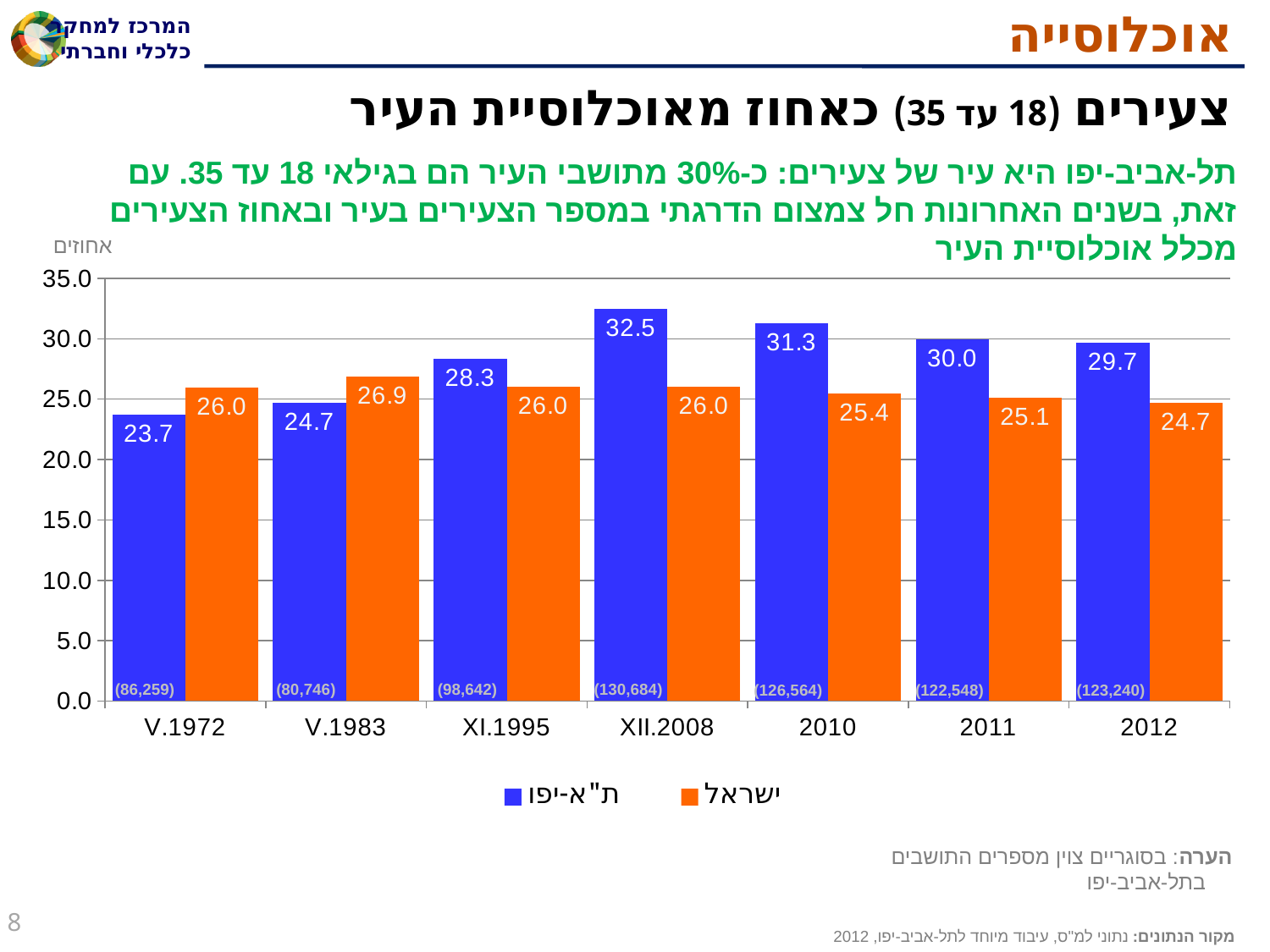
Is the ישראל value in 2011 greater or less than 30.0? less How many categories are shown on the x axis? 7 In which category is the ת"א-יפו value highest? XII.2008 What is the value for ת"א-יפו in 2012? 29.7 What is the difference between the ת"א-יפו and ישראל values in 2010? 5.9 How many series does the legend list? 2 Does the ישראל value rise or fall from XII.2008 to 2012? fall Which is larger in V.1972, the ת"א-יפו value or the ישראל value? ישראל What is the value for ישראל in V.1983? 26.9 What kind of chart is shown on the slide? bar chart In which category is the ת"א-יפו value lowest? V.1972 What is the value for ת"א-יפו in XII.2008? 32.5